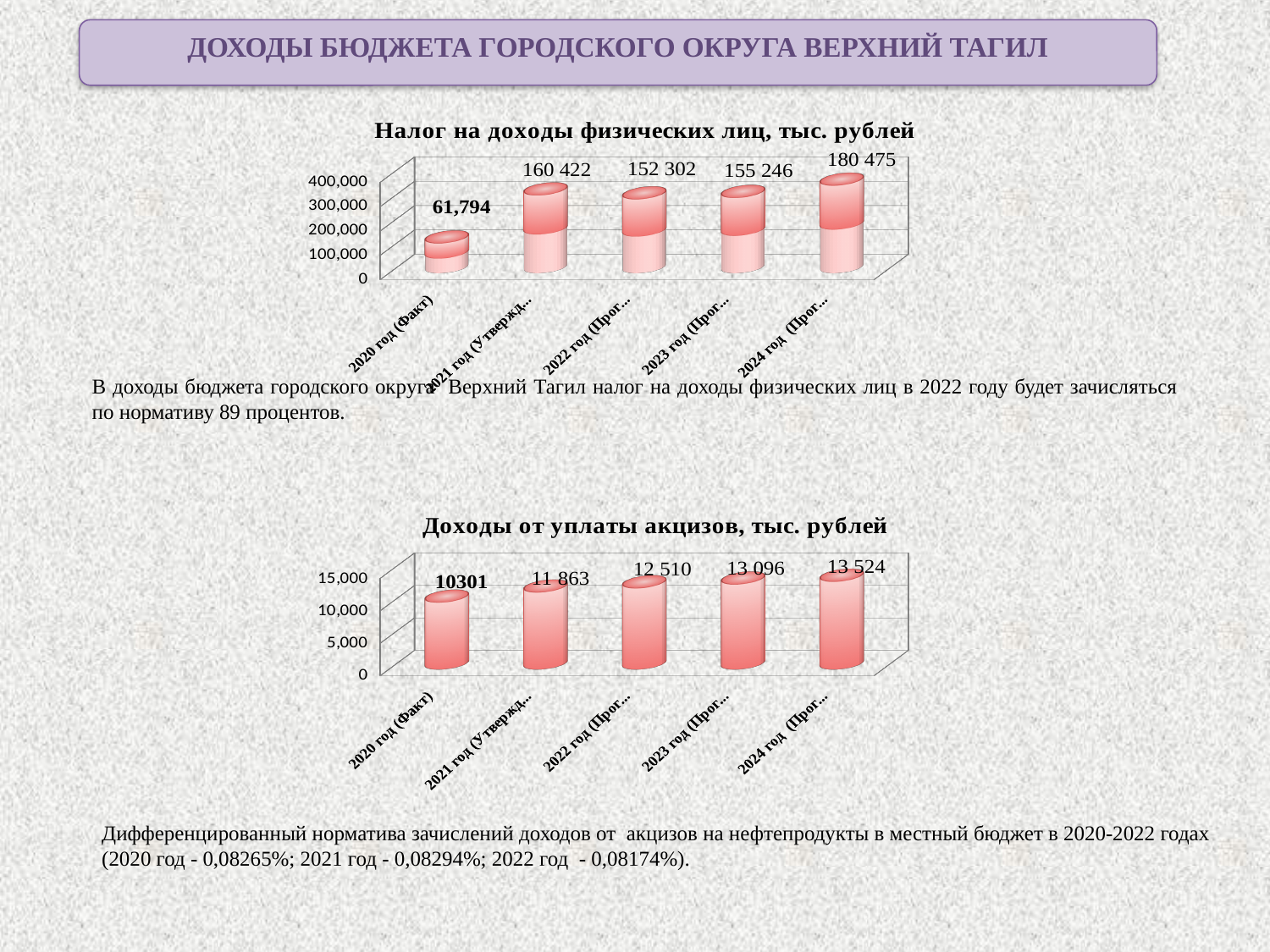
In the chart 'Налог на доходы физических лиц, тыс. рублей', what is the difference between the 2024 and 2021 values? 20 053 In the chart 'Налог на доходы физических лиц, тыс. рублей', which year has the highest value? 2024 год In the chart 'Доходы от уплаты акцизов, тыс. рублей', what is the value for 2022 год? 12 510 In the chart 'Налог на доходы физических лиц, тыс. рублей', which is larger: the value for 2022 год or 2023 год? 2023 год In the chart 'Доходы от уплаты акцизов, тыс. рублей', what is the difference between the 2022 and 2021 values? 647 In the chart 'Доходы от уплаты акцизов, тыс. рублей', do the values rise or fall from 2020 to 2024? rise What type of chart is the bottom chart 'Доходы от уплаты акцизов, тыс. рублей'? bar chart In the chart 'Налог на доходы физических лиц, тыс. рублей', which year has the lowest value? 2020 год (Факт) In the chart 'Налог на доходы физических лиц, тыс. рублей', what is the value for 2020 год (Факт)? 61,794 In the chart 'Доходы от уплаты акцизов, тыс. рублей', what is the value for 2020 год (Факт)? 10301 How many bars are shown in the chart 'Налог на доходы физических лиц, тыс. рублей'? 5 In the chart 'Налог на доходы физических лиц, тыс. рублей', what is the value for 2024 год? 180 475